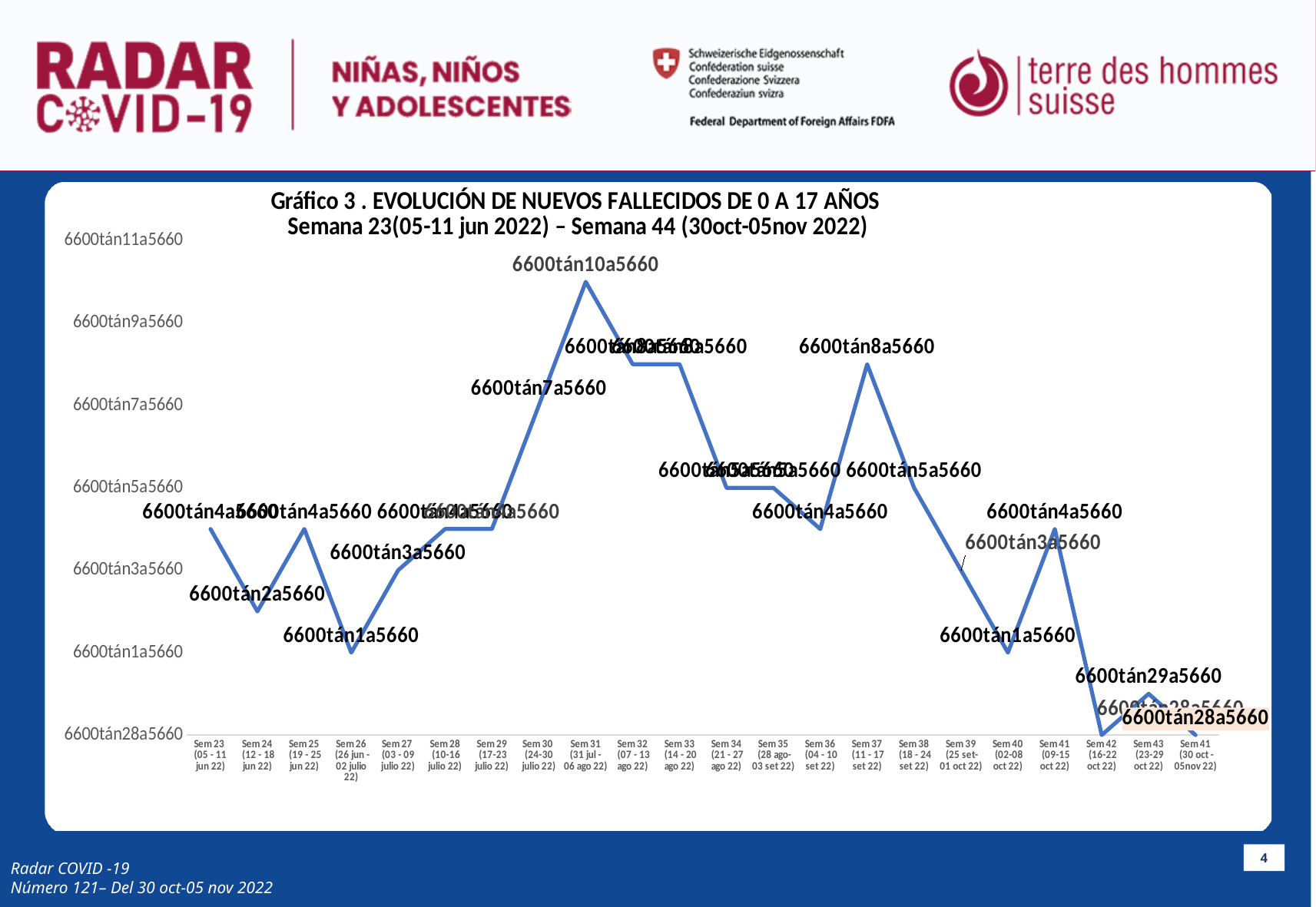
Which is larger, the value for Sem 37 or the value for Sem 40? Sem 37 How many weeks are plotted along the x axis? 22 Which is larger, the value for Sem 31 or the value for Sem 26? Sem 31 Do the values rise or fall from Sem 41 (09-15 oct 22) to Sem 42 (16-22 oct 22)? fall Which is larger, the value for Sem 25 or the value for Sem 26? Sem 25 Do the values rise or fall from Sem 37 to Sem 40? fall Which week has the highest value on the chart? Sem 31 (31 jul - 06 ago 22) What colour is the line on the chart? blue What kind of chart is shown on the slide? line chart What is the title of the chart? Gráfico 3 . EVOLUCIÓN DE NUEVOS FALLECIDOS DE 0 A 17 AÑOS Semana 23(05-11 jun 2022) – Semana 44 (30oct-05nov 2022) Do the values rise or fall from Sem 26 to Sem 31? rise